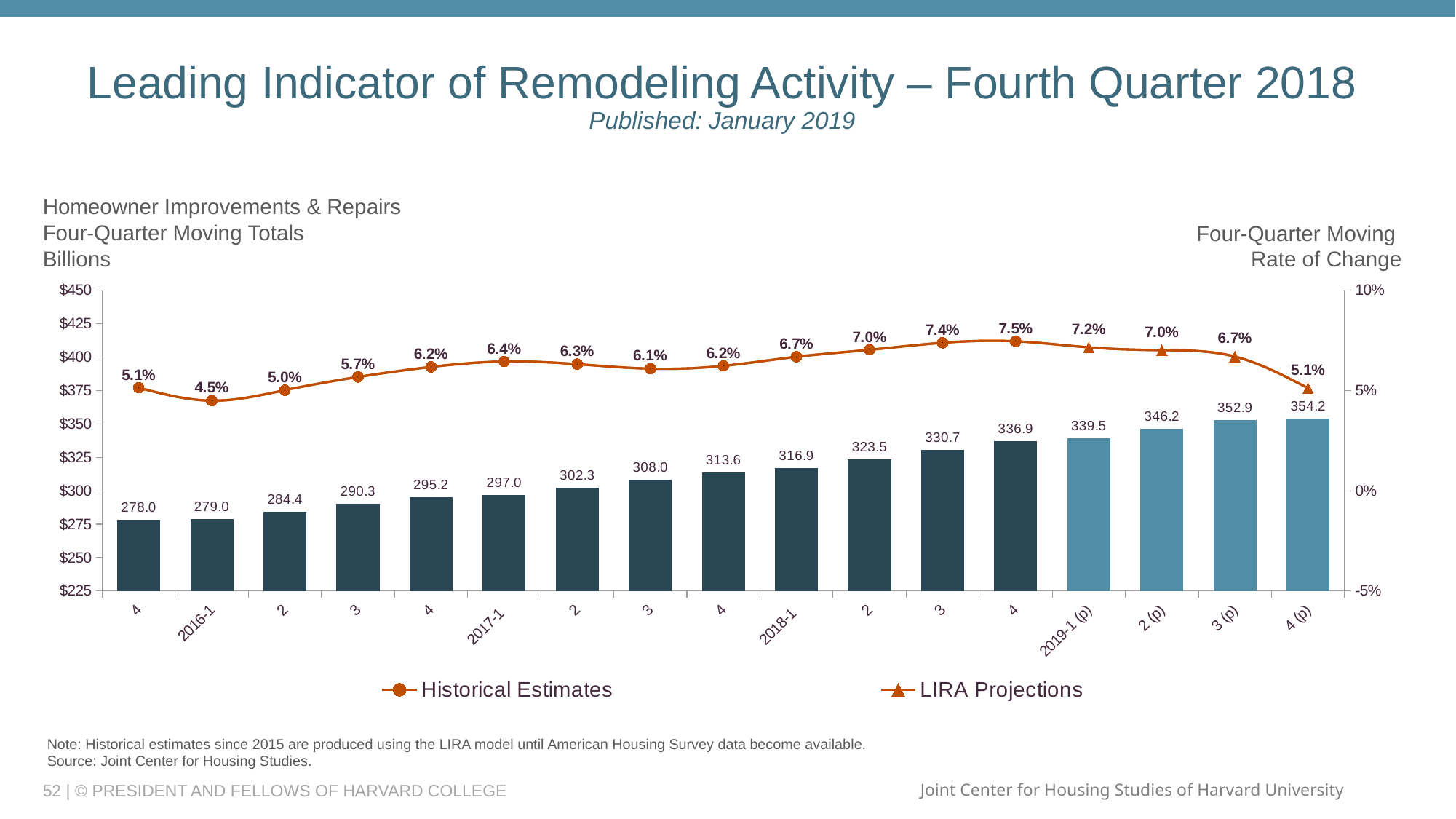
Which quarter has the lowest four-quarter moving rate of change on the line? 2016-1 What is the highest rate of change value shown on the line, and in which quarter does it occur? 7.5%, 2018-4 Do the four-quarter moving total bars rise or fall from left to right across the chart? rise Which quarter has the highest four-quarter moving total bar? 4 (p) Is the four-quarter moving total bar for 2017-4 greater or less than $300? greater How many bars (quarters) are plotted on the chart? 17 What is the difference between the four-quarter moving totals for 2018-4 (336.9) and 2018-1 (316.9)? 20.0 How many series does the legend list? 2 Which is larger, the rate of change for 2017-2 or for 2017-3? 2017-2 What is the four-quarter moving rate of change shown for 2017-1? 6.4% What is the four-quarter moving total (in billions) for 2019-1 (p)? 339.5 What is the four-quarter moving total (in billions) for 2018-1? 316.9